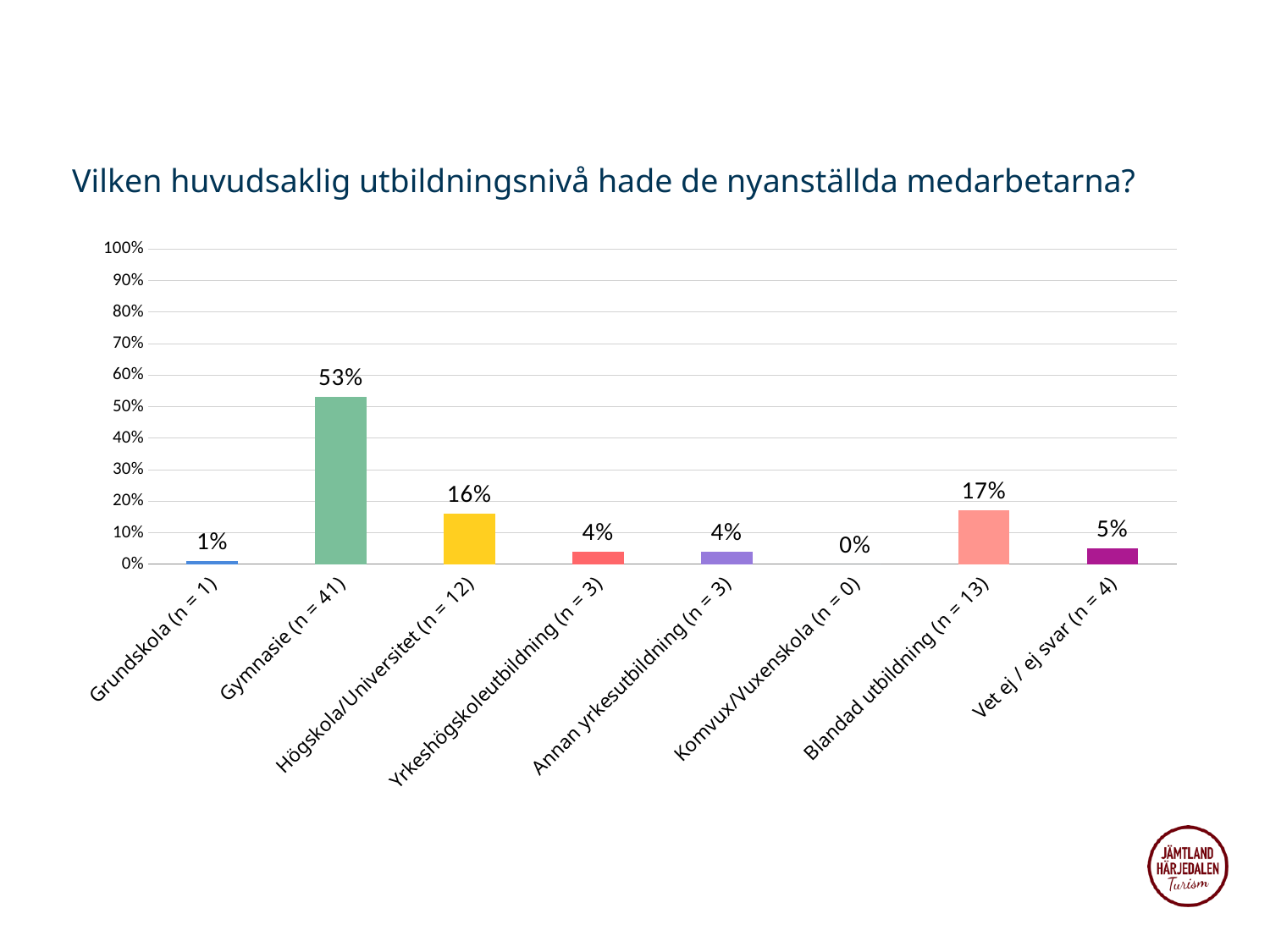
Which category has the highest value? Gymnasie (n = 41) Which category has the lowest value? Komvux/Vuxenskola (n = 0) Which is larger, the value for Högskola/Universitet (n = 12) or the value for Blandad utbildning (n = 13)? Blandad utbildning (n = 13) What is the value for Högskola/Universitet (n = 12)? 16% How many categories are shown on the x axis? 8 What kind of chart is shown on the slide? bar chart What is the value for Vet ej / ej svar (n = 4)? 5% What is the title of the chart? Vilken huvudsaklig utbildningsnivå hade de nyanställda medarbetarna? What is the value for Blandad utbildning (n = 13)? 17% What is the difference between the values for Gymnasie (n = 41) and Blandad utbildning (n = 13)? 36% What is the value for Gymnasie (n = 41)? 53% Is the value for Gymnasie (n = 41) greater or less than 50%? greater